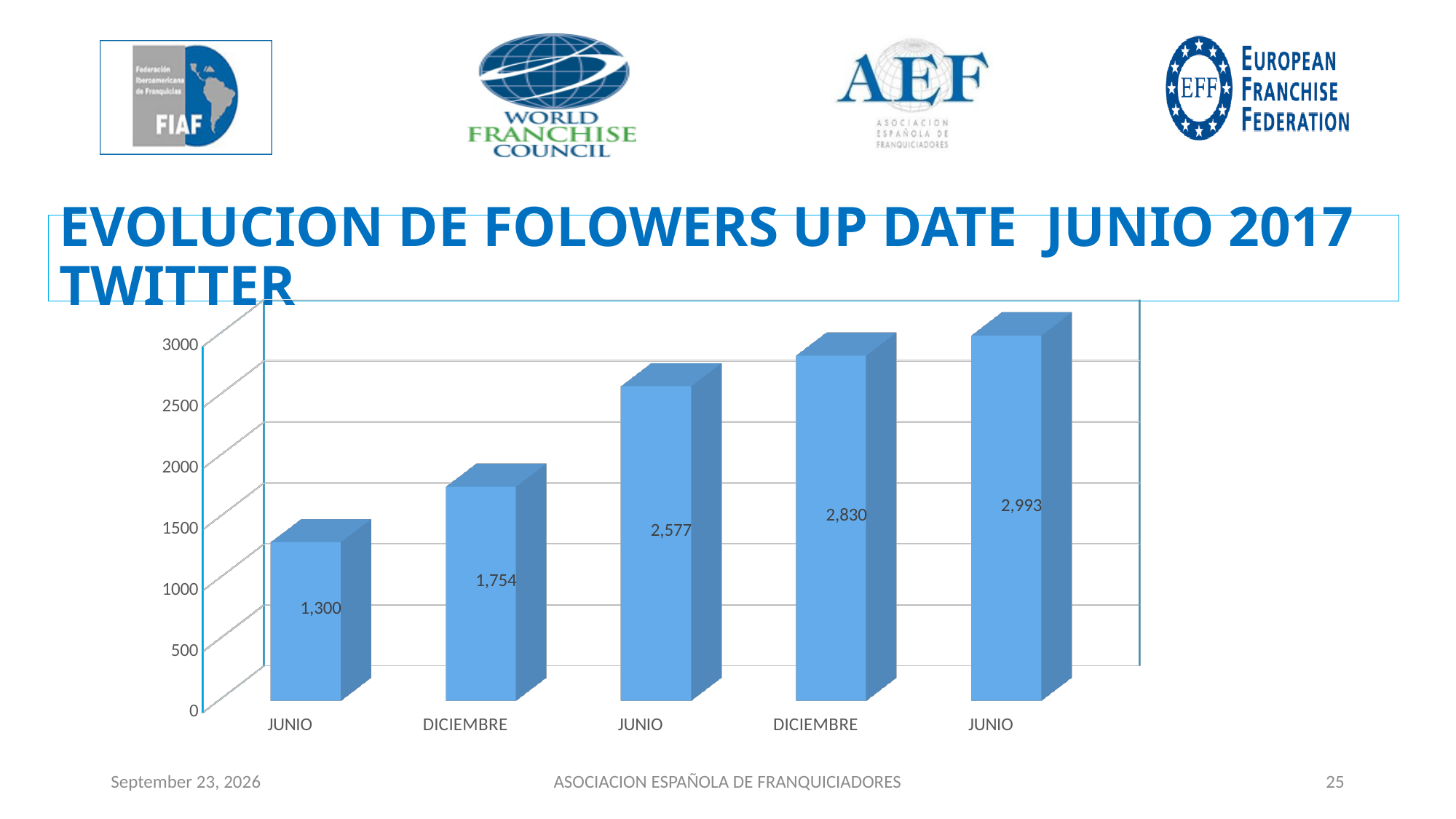
What is the title of the chart on the slide? EVOLUCION DE FOLOWERS UP DATE JUNIO 2017 TWITTER Do the values rise or fall from left to right along the x axis? rise How many bars are plotted in the chart? 5 What is the value of the last bar (the rightmost JUNIO)? 2,993 What is the difference between the last bar (2,993) and the first bar (1,300)? 1,693 What is the value of the first bar (the leftmost JUNIO)? 1,300 What is the value of the fourth bar (the second DICIEMBRE)? 2,830 Which bar has the highest value? the last JUNIO (rightmost bar) What kind of chart is shown on the slide? bar chart What is the value of the middle bar (the second JUNIO)? 2,577 Which bar has the lowest value? the first JUNIO (leftmost bar) What is the value of the second bar (the first DICIEMBRE)? 1,754